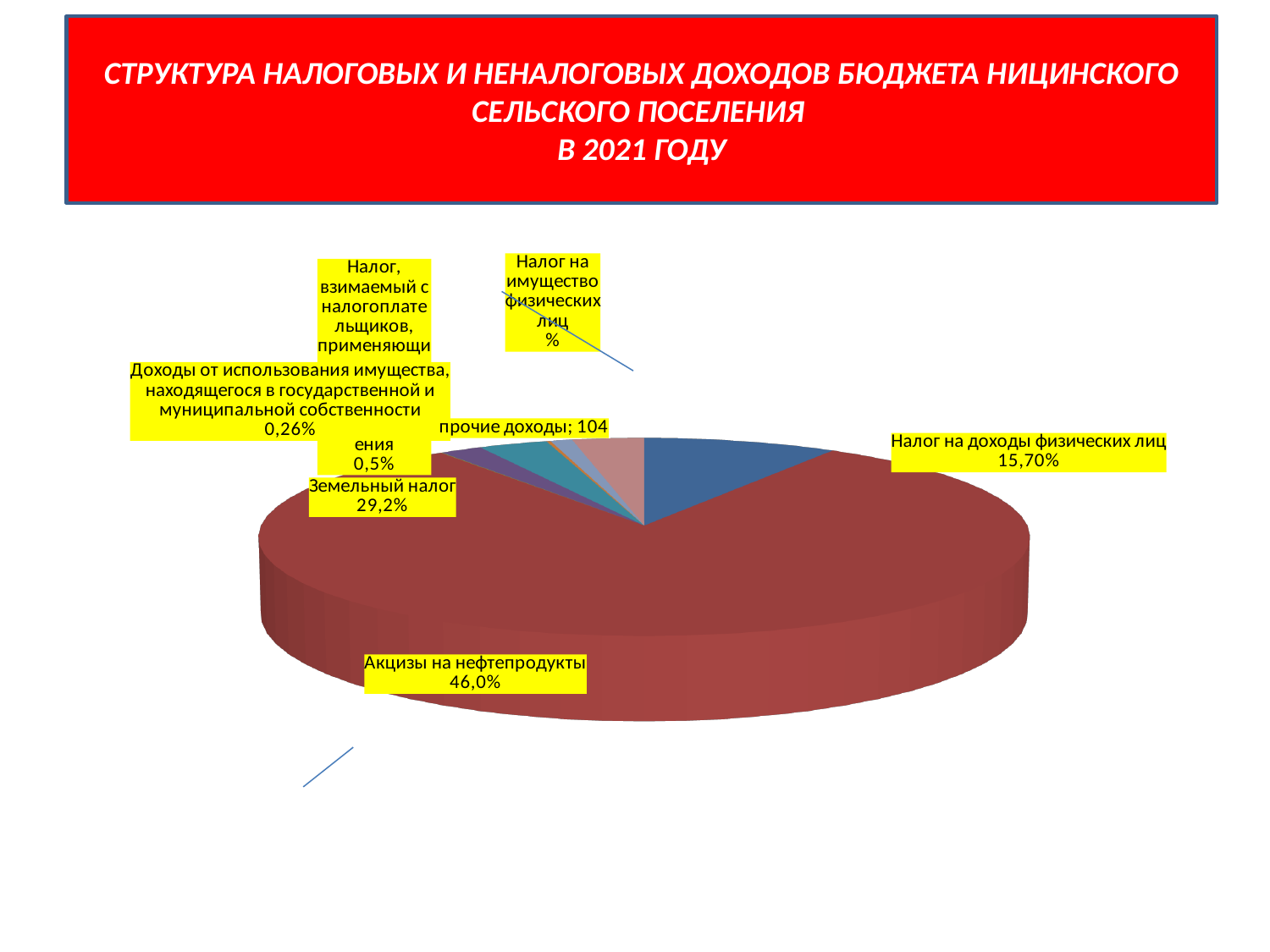
What share of the pie is labelled for Акцизы на нефтепродукты? 46,0% What year does the chart title say the budget revenue structure refers to? 2021 What kind of chart is shown on the slide? pie chart Which is larger: the share for Налог на доходы физических лиц or for Доходы от использования имущества, находящегося в государственной и муниципальной собственности? Налог на доходы физических лиц What colour is the slice for Акцизы на нефтепродукты? red Which category has the largest share of the pie? Акцизы на нефтепродукты What share is shown for Налог на доходы физических лиц? 15,70% By how many percentage points does the share for Акцизы на нефтепродукты exceed the share for Земельный налог? 16,8% What share is shown for Доходы от использования имущества, находящегося в государственной и муниципальной собственности? 0,26% What share is shown for Земельный налог? 29,2%